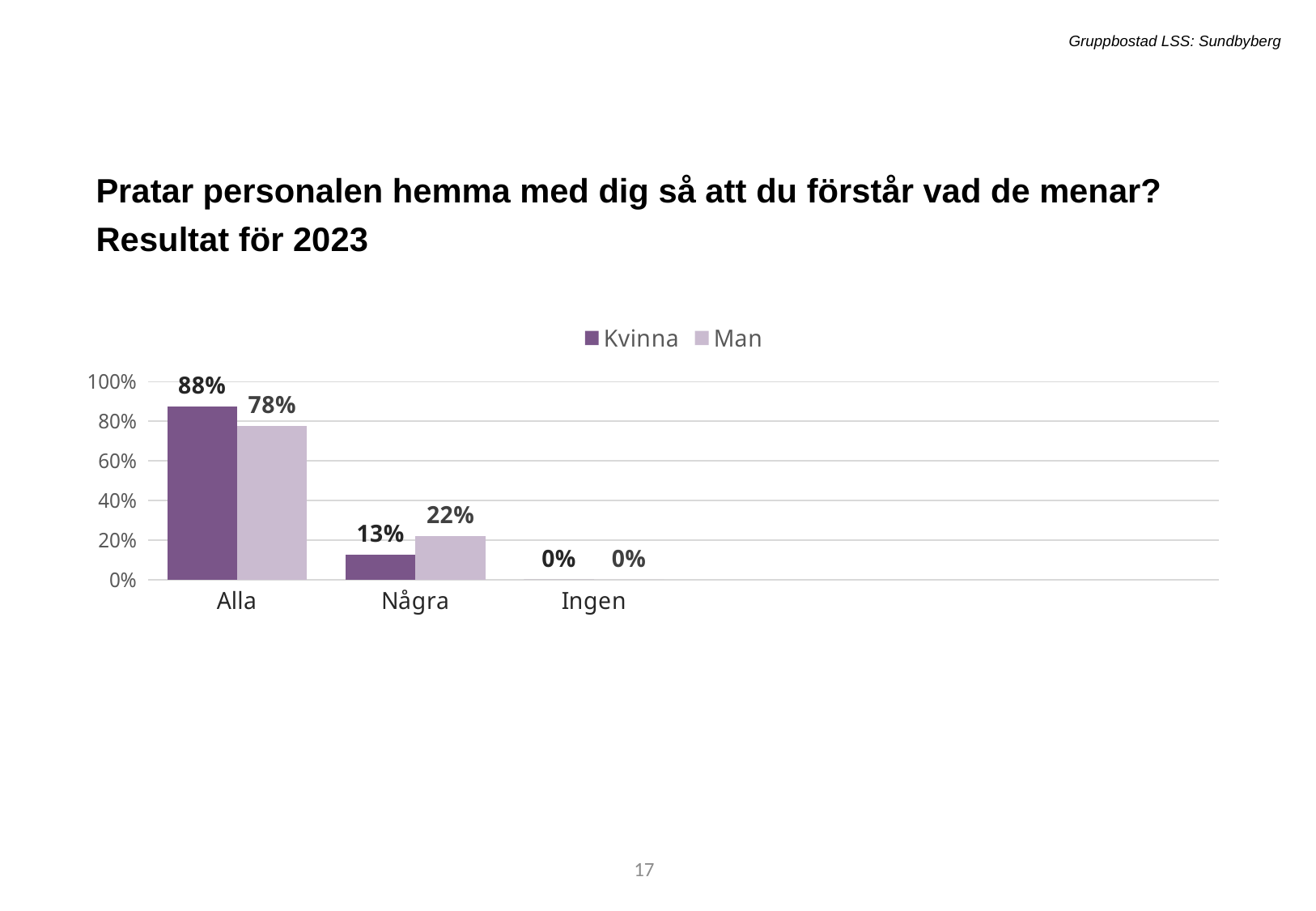
What is the value for Man in the Alla category? 78% What is the value for Kvinna in the Ingen category? 0% Which category has the lowest value for Man? Ingen What kind of chart is shown on the slide? Bar chart How many series does the legend list? 2 What is the difference between the Kvinna and Man values in the Alla category? 10% What is the value for Kvinna in the Några category? 13% How many categories are shown on the x axis? 3 What is the value for Man in the Några category? 22% What is the value for Kvinna in the Alla category? 88% Which category has the highest value for Kvinna? Alla In the Några category, which series has the larger value, Kvinna or Man? Man